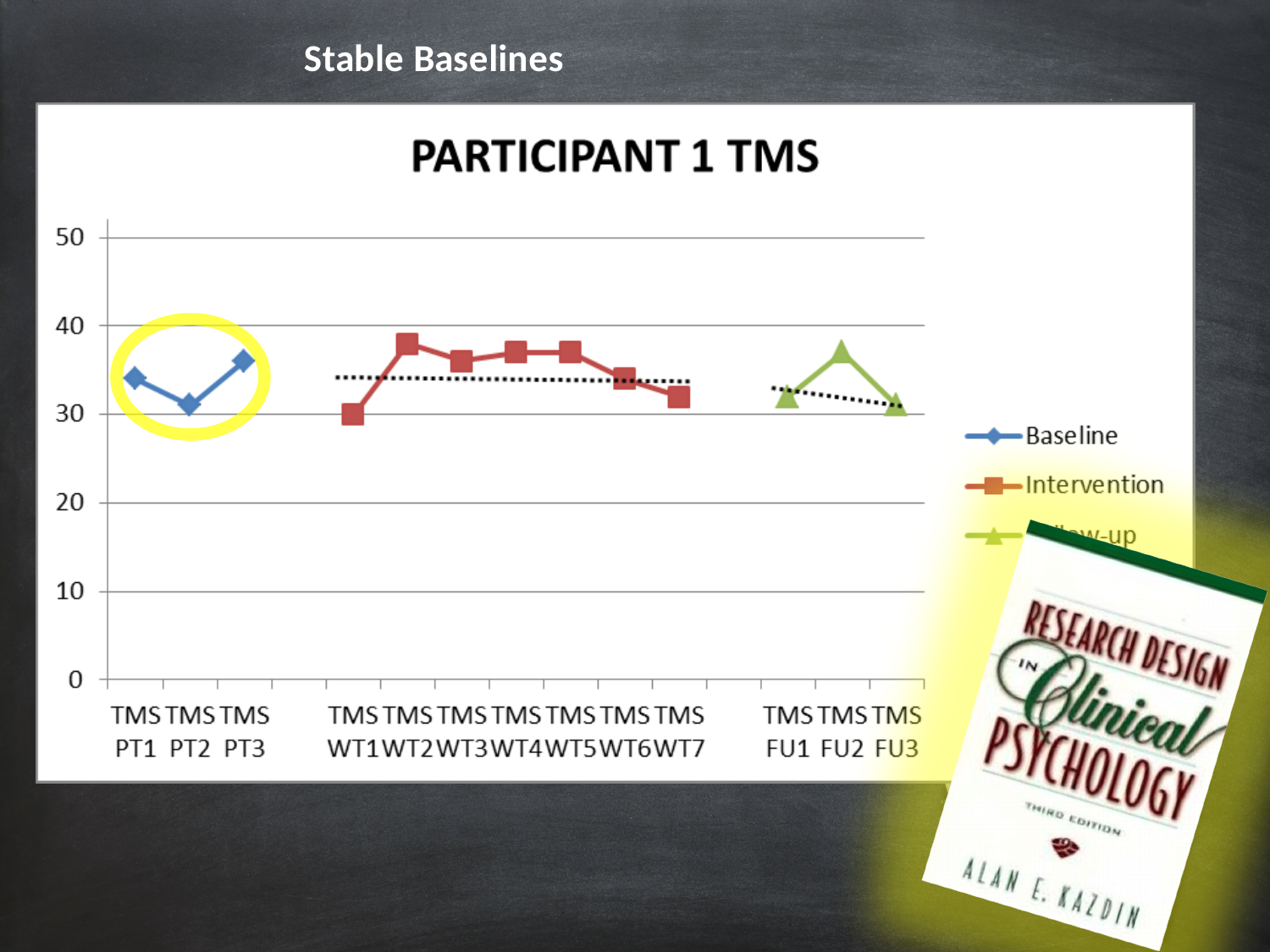
Is the value for TMS FU2 greater or less than 30? greater Which baseline point (PT1, PT2 or PT3) has the lowest value? TMS PT2 Which is larger, the value for TMS PT3 or TMS PT2? TMS PT3 Which intervention point (WT1 to WT7) has the lowest value? TMS WT1 How many data points are plotted along the x axis in total? 13 Is the value for TMS WT2 greater or less than 40? less Is the value for TMS PT3 greater or less than 40? less Which series is circled in yellow on the chart? Baseline How many series does the chart's legend list? 3 What type of chart is shown on the slide? line chart What is the title of the chart? PARTICIPANT 1 TMS Do the Intervention values rise or fall from TMS WT2 to TMS WT7? fall